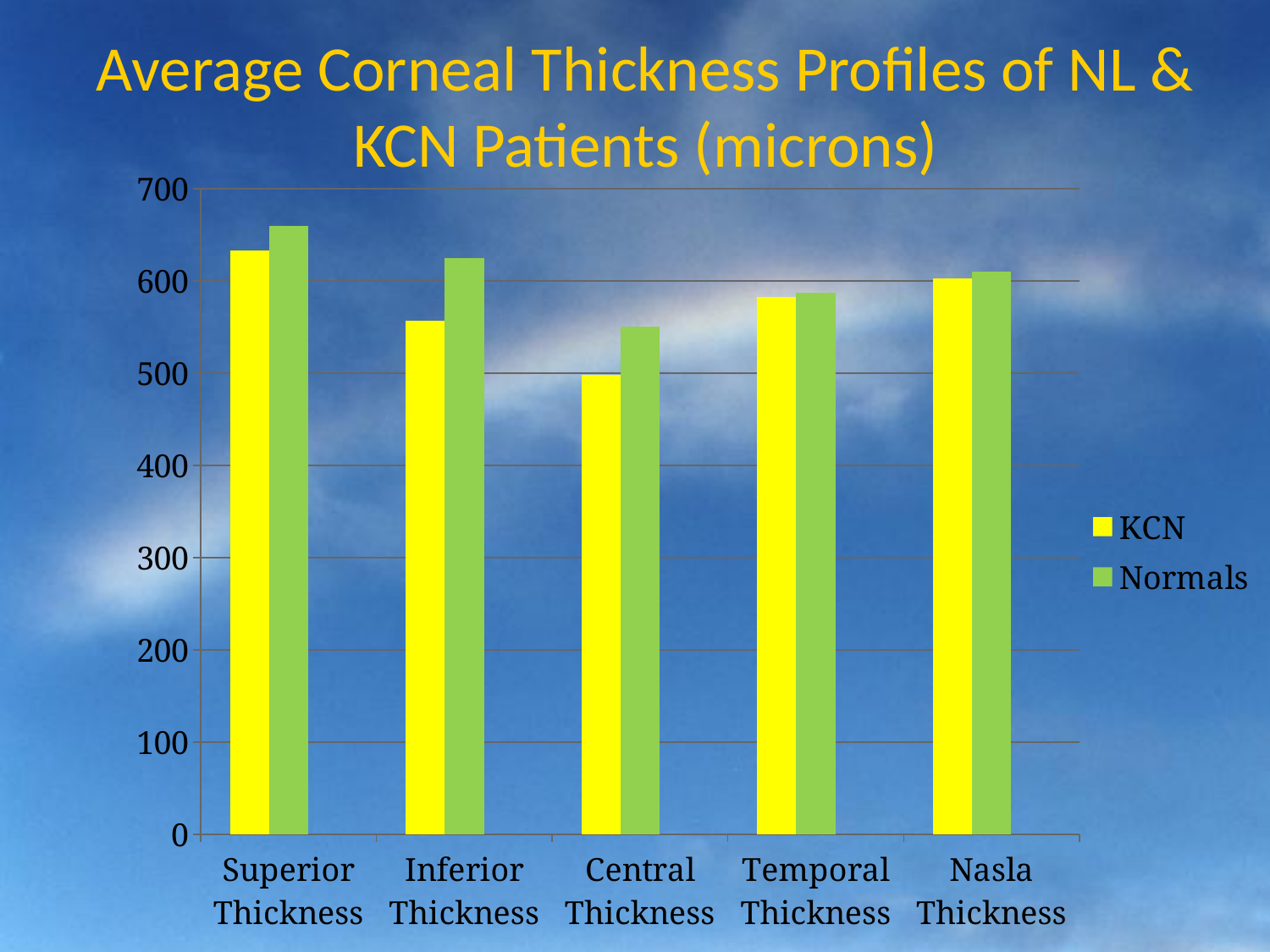
For Inferior Thickness, which series has the larger value, KCN or Normals? Normals How many thickness categories are shown on the x axis? 5 Is the Normals value for Central Thickness greater or less than 500? greater Is the KCN value for Inferior Thickness greater or less than 600? less How many series does the legend list? 2 Which colour represents the KCN series in the legend? yellow Which category has the highest Normals value? Superior Thickness What unit is given in the chart title? microns Is the KCN value for Superior Thickness greater or less than 700? less What kind of chart is shown on the slide? bar chart Which category has the lowest KCN value? Central Thickness